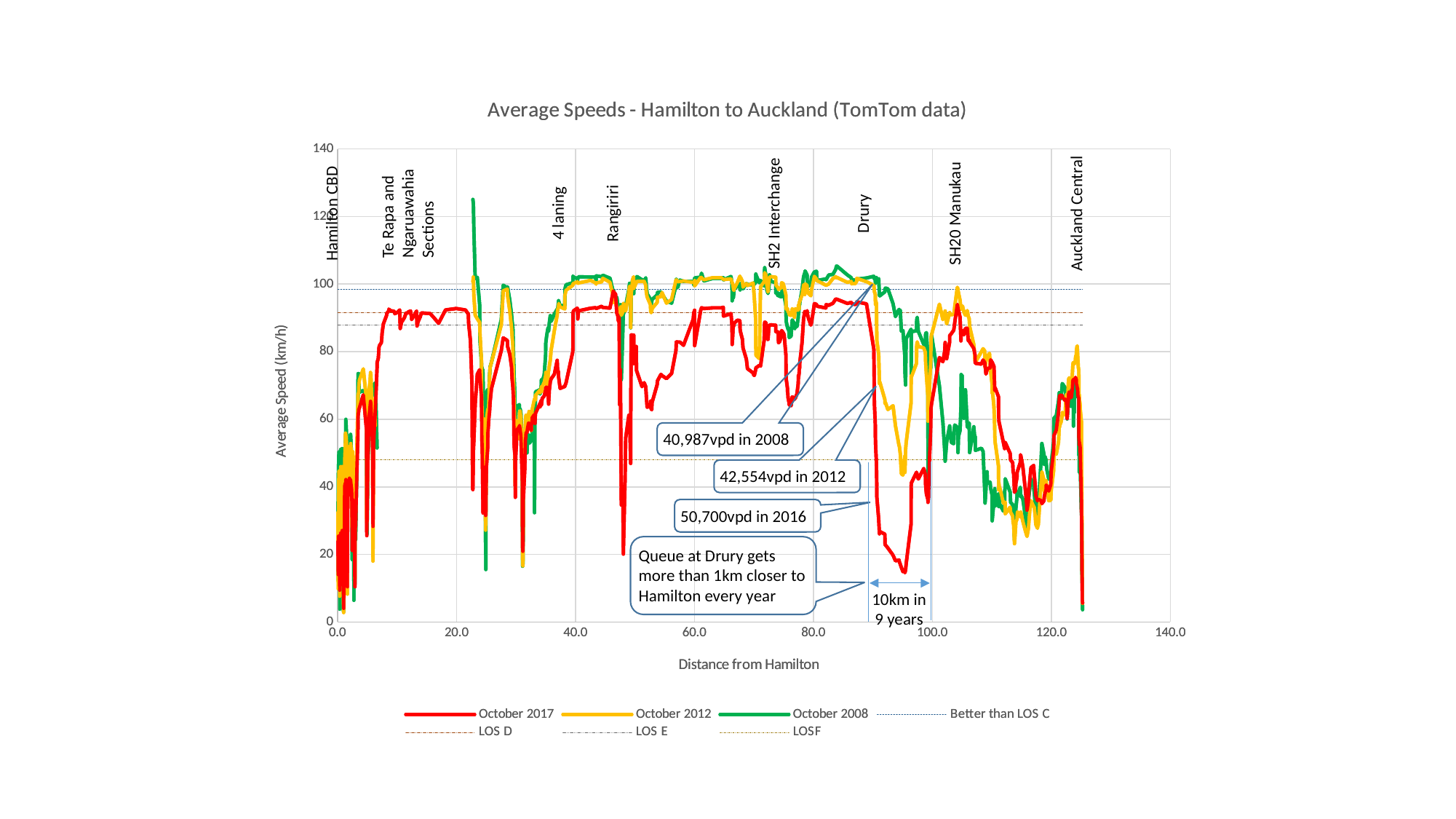
At about 95 km from Hamilton, which series shows the higher average speed, October 2017 or October 2008? October 2008 What is the label of the vertical axis? Average Speed (km/h) How many entries does the chart legend list? 7 What is the title of the chart? Average Speeds - Hamilton to Auckland (TomTom data) Is the October 2008 average speed at about 110 km from Hamilton greater or less than 60 km/h? less Is the October 2017 average speed at about 95 km from Hamilton greater or less than 40 km/h? less What traffic volume is annotated for 2012 on the chart? 42,554vpd What traffic volume is annotated for 2008 on the chart? 40,987vpd What kind of chart is shown on the slide? line chart Which colour is used for the October 2017 series? red Between about 90 km and 95 km from Hamilton, does the October 2017 average speed rise or fall? fall What traffic volume is annotated for 2016 on the chart? 50,700vpd